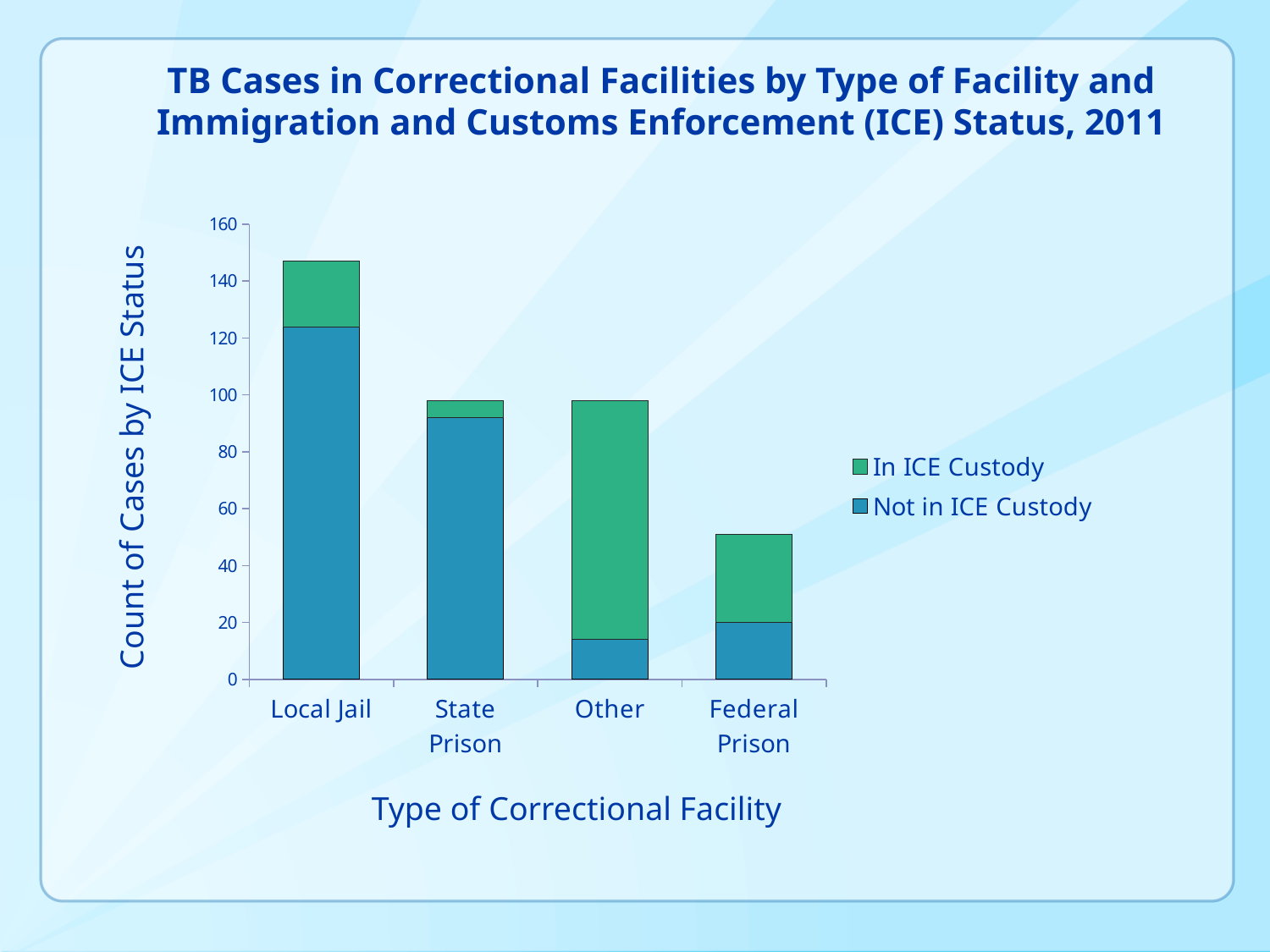
How many types of correctional facility are shown on the x axis? 4 Is the total count of cases for Local Jail greater or less than 140? greater Which has more cases Not in ICE Custody: Local Jail or Federal Prison? Local Jail Which has more cases In ICE Custody: Other or Local Jail? Other Which type of correctional facility has the highest total count of TB cases? Local Jail How many series does the legend list? 2 Which type of correctional facility has the lowest total count of TB cases? Federal Prison What is the title of the y axis? Count of Cases by ICE Status Is the Not in ICE Custody count for Other greater or less than 20? less Is the Not in ICE Custody count for State Prison greater or less than 80? greater What kind of chart is shown on the slide? Stacked bar chart